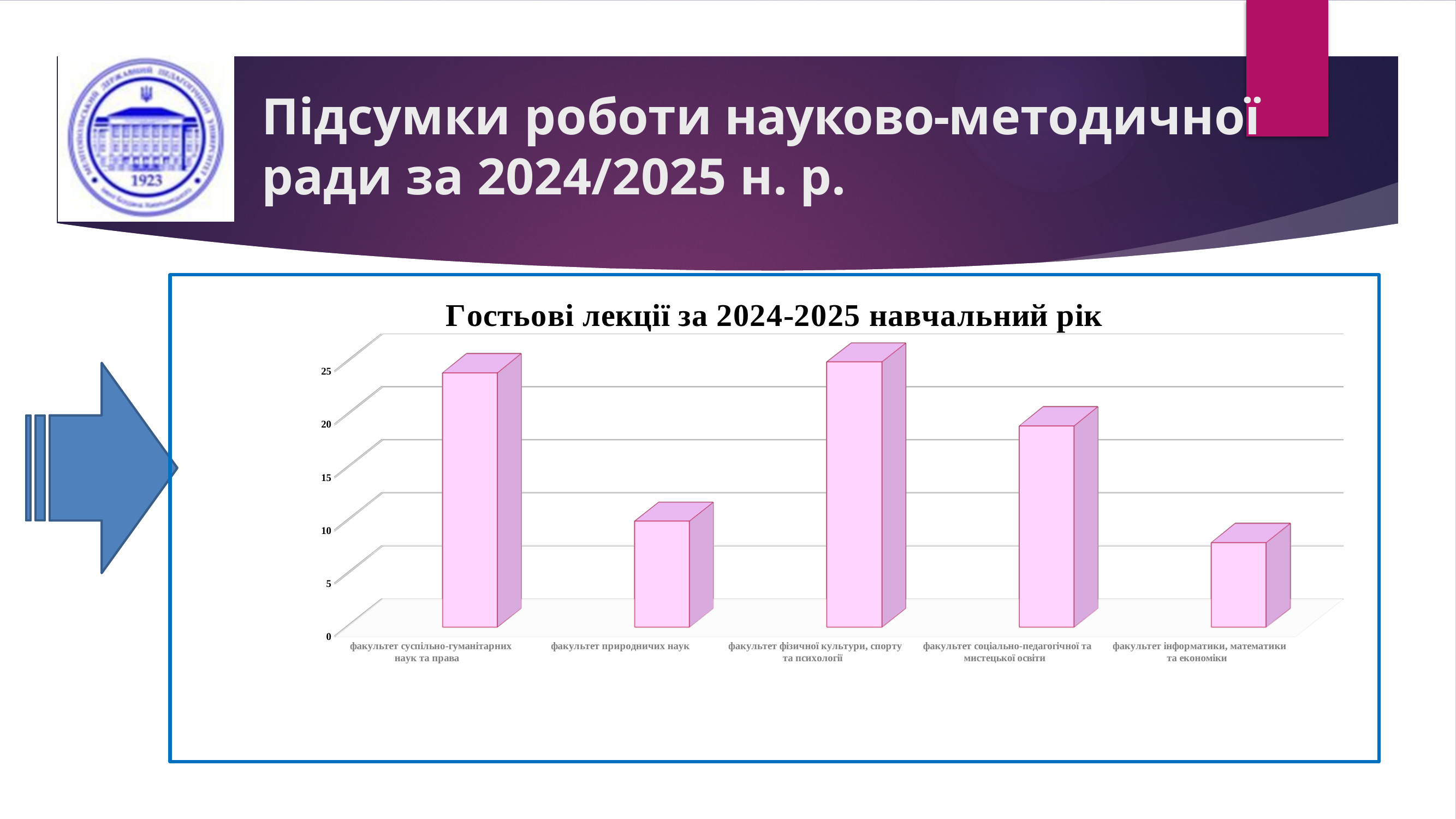
Which faculty has the highest number of guest lectures? факультет фізичної культури, спорту та психології What is the title of the chart? Гостьові лекції за 2024-2025 навчальний рік Is the value for факультет природничих наук greater or less than 15? less Is the value for факультет фізичної культури, спорту та психології greater or less than 20? greater Is the value for факультет соціально-педагогічної та мистецької освіти greater or less than 15? greater What kind of chart is shown on the slide? bar chart Which has more guest lectures: факультет суспільно-гуманітарних наук та права or факультет природничих наук? факультет суспільно-гуманітарних наук та права How many faculties (categories) are shown on the chart? 5 Which has more guest lectures: факультет соціально-педагогічної та мистецької освіти or факультет інформатики, математики та економіки? факультет соціально-педагогічної та мистецької освіти Which faculty has the lowest number of guest lectures? факультет інформатики, математики та економіки